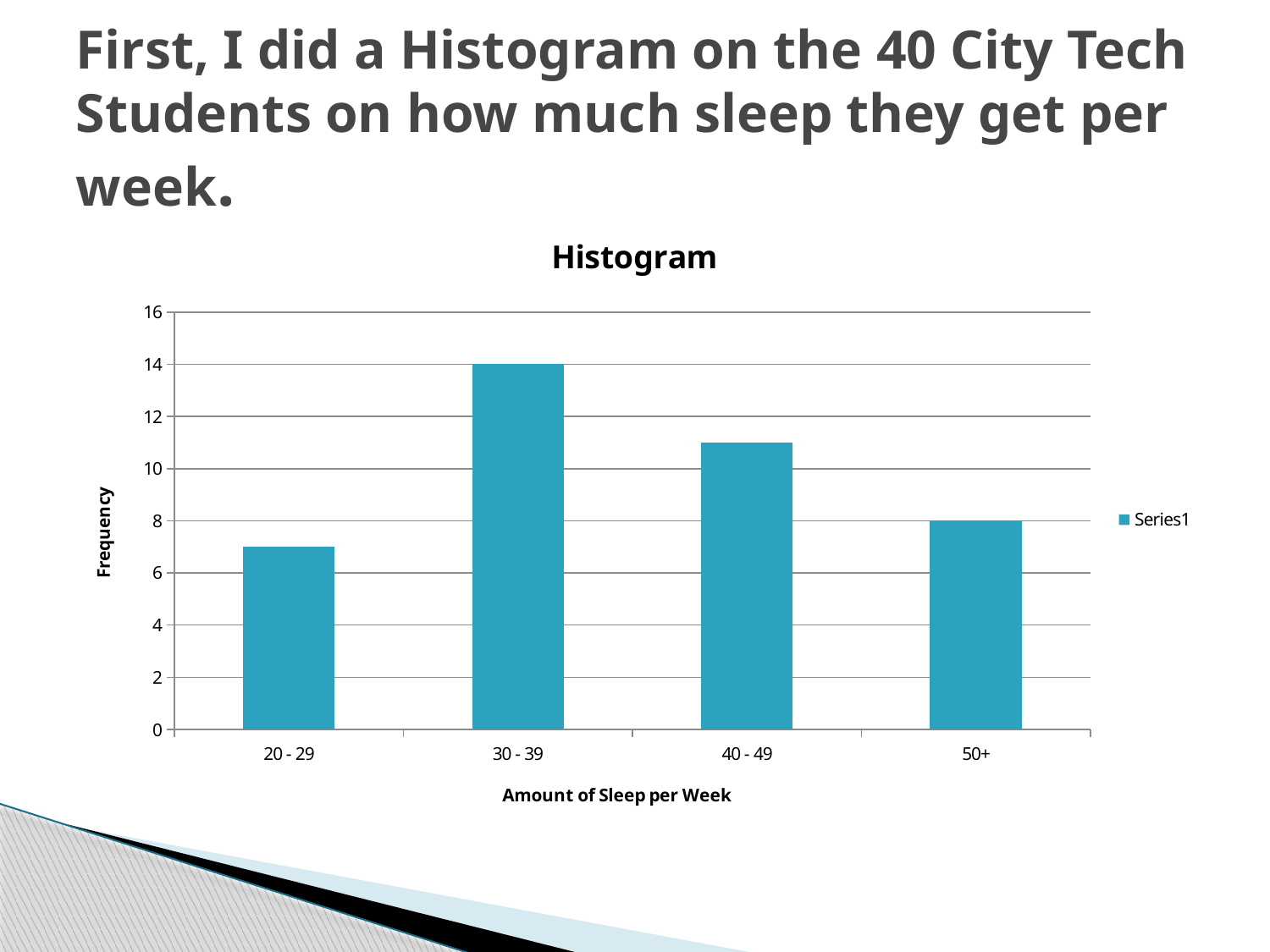
Which category has the lowest frequency? 20 - 29 How many categories are shown on the x axis? 4 Is the frequency for 40 - 49 greater or less than 10? greater How many series does the legend list? 1 What is the frequency for the 50+ category? 8 What kind of chart is shown on the slide? bar chart Which has a higher frequency, 40 - 49 or 50+? 40 - 49 What is the difference in frequency between the 30 - 39 and 50+ categories? 6 What is the label of the vertical axis? Frequency Is the frequency for 20 - 29 greater or less than 8? less Which category has the highest frequency? 30 - 39 What is the frequency for the 30 - 39 category? 14